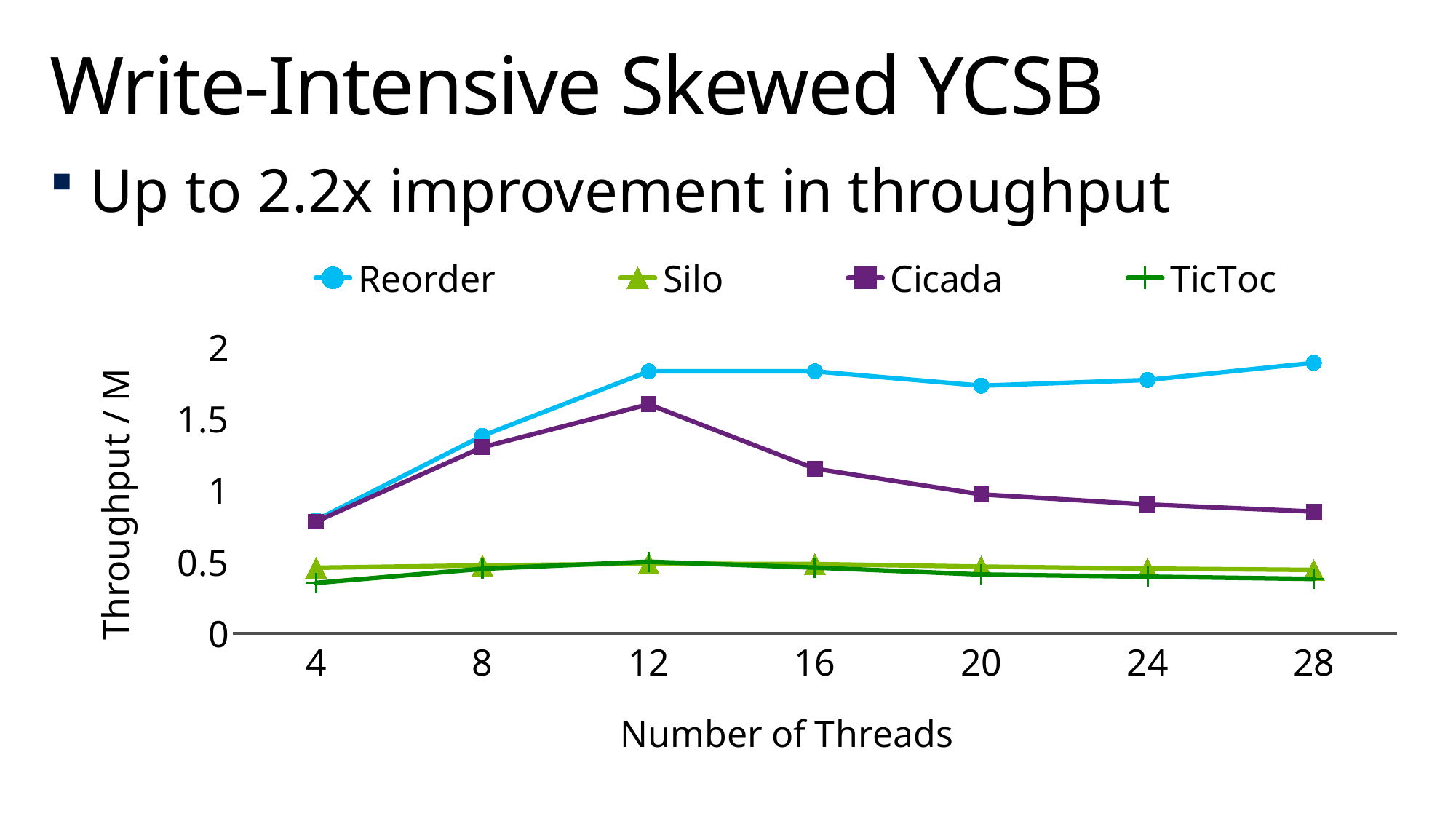
What kind of chart is shown on the slide? line chart Is the Reorder throughput at 28 threads greater or less than 1.5? greater At 16 threads, which has higher throughput, Reorder or Cicada? Reorder What is the label of the y axis? Throughput / M At which number of threads does Cicada reach its highest throughput? 12 Is the TicToc throughput at 4 threads greater or less than 0.5? less Which series has the highest throughput at 28 threads? Reorder How many series does the legend list? 4 Which series has the lowest throughput at 4 threads? TicToc How many thread counts are plotted along the x axis? 7 Is the Cicada throughput at 28 threads greater or less than 1? less Does the Cicada throughput rise or fall from 12 threads to 28 threads? fall